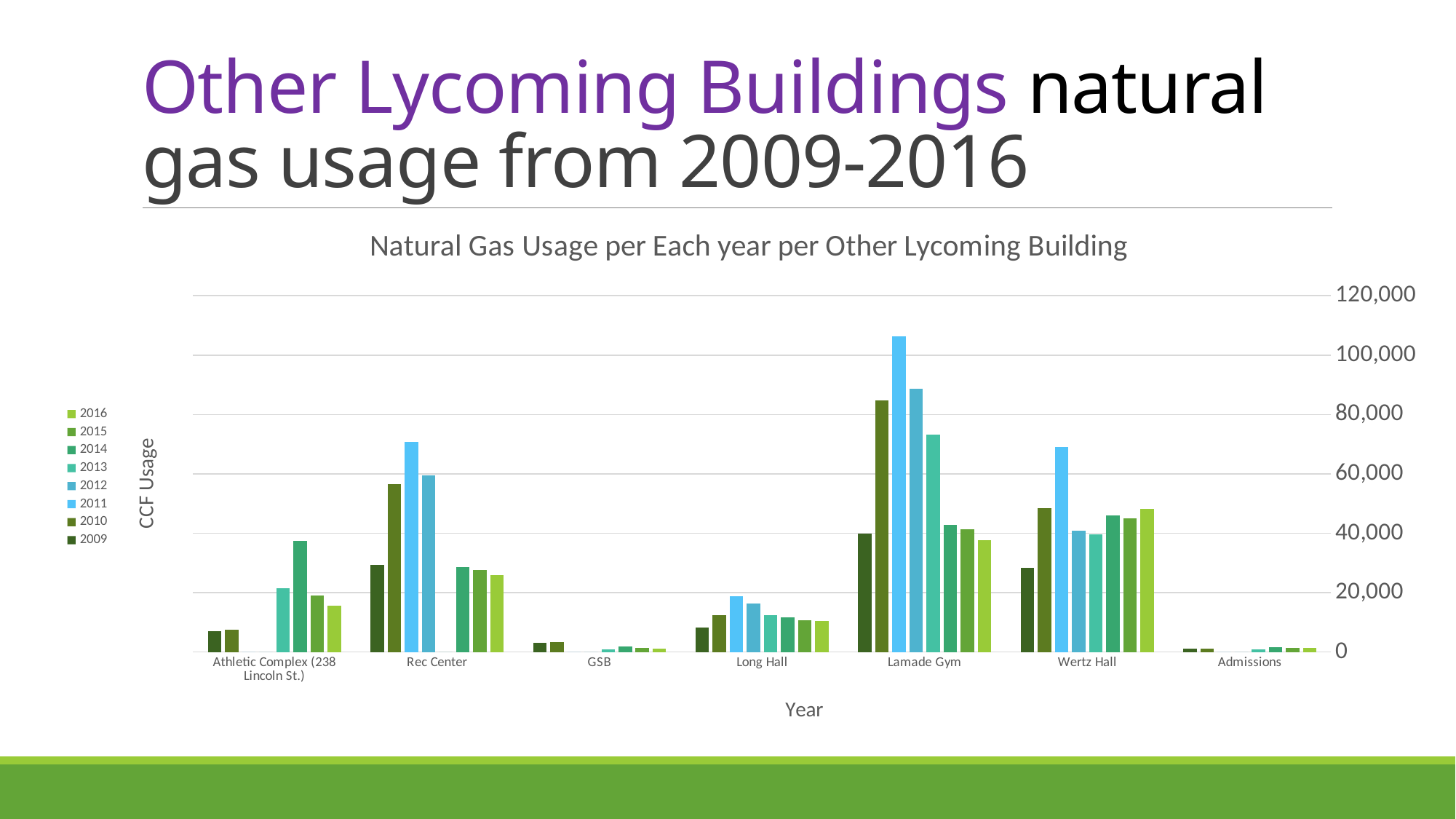
Is the 2011 value for Lamade Gym greater or less than 100,000? greater Which is larger: the 2011 value for Lamade Gym or the 2011 value for Wertz Hall? Lamade Gym Which building has the highest natural gas usage bar in the chart? Lamade Gym Is the 2009 value for Athletic Complex (238 Lincoln St.) greater or less than 20,000? less What kind of chart is shown on the slide? bar chart What is the label on the vertical axis? CCF Usage How many series (years) does the legend list? 8 What is the title of the chart? Natural Gas Usage per Each year per Other Lycoming Building For Lamade Gym, do the values rise or fall from 2011 to 2016? fall How many buildings (categories) are shown on the x axis? 7 Which building has the lowest natural gas usage across all years? Admissions Is the 2011 value for Rec Center greater or less than 60,000? greater